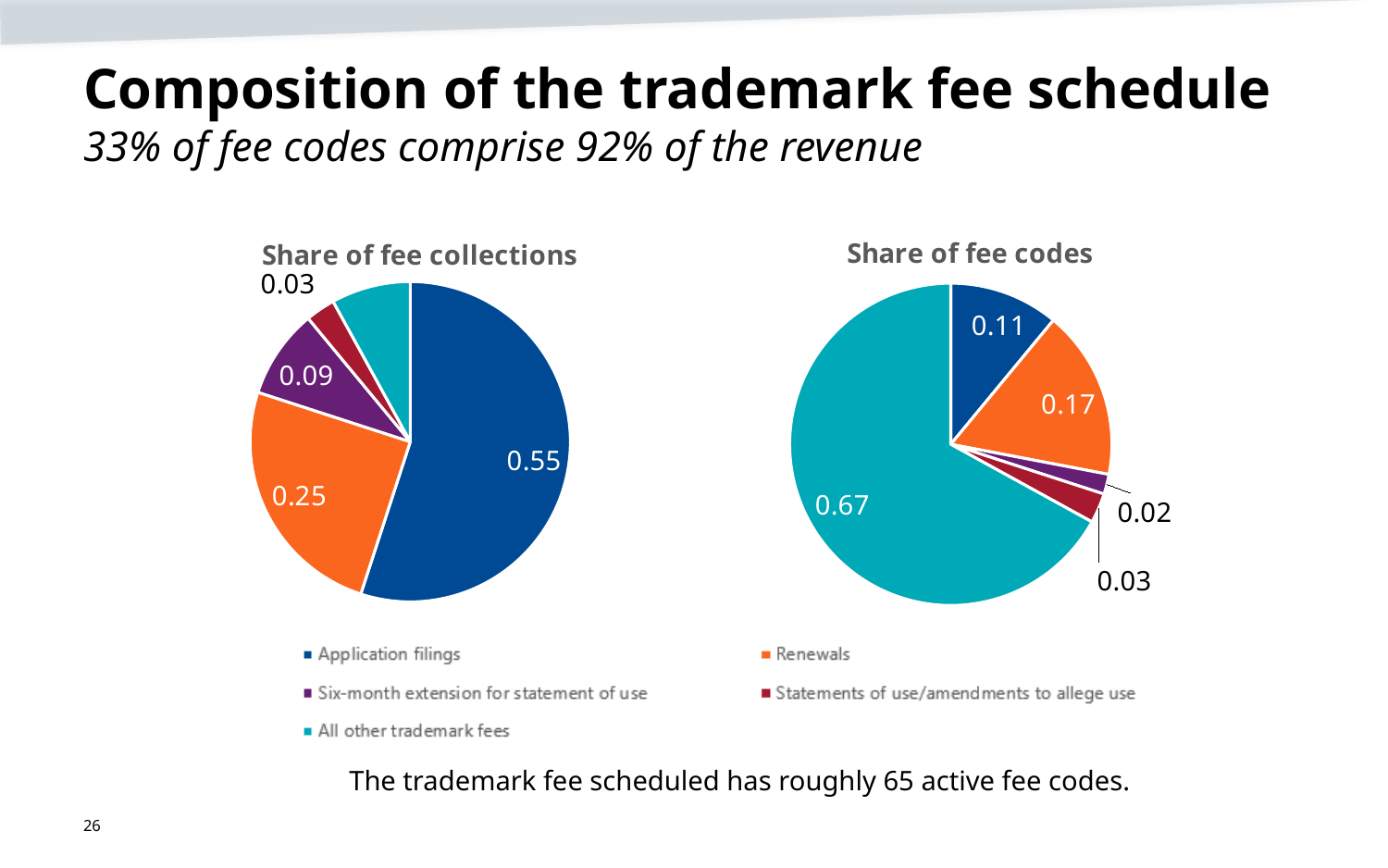
In the 'Share of fee codes' pie chart, what is the value for All other trademark fees? 0.67 In the 'Share of fee collections' pie chart, which category has the largest slice? Application filings In the 'Share of fee collections' pie chart, what is the value for Renewals? 0.25 How many entries does the legend list for the pie charts? 5 In the 'Share of fee codes' pie chart, what is the value for Application filings? 0.11 In the 'Share of fee collections' pie chart, what is the difference between the values for Application filings and Renewals? 0.30 In the 'Share of fee codes' pie chart, what is the value for Renewals? 0.17 In the 'Share of fee codes' pie chart, which category has the smallest slice? Six-month extension for statement of use In the 'Share of fee collections' pie chart, what is the value for Application filings? 0.55 In the 'Share of fee codes' pie chart, which is larger: Renewals or Application filings? Renewals In the 'Share of fee collections' pie chart, what is the value for Six-month extension for statement of use? 0.09 In the 'Share of fee codes' pie chart, which category has the largest slice? All other trademark fees